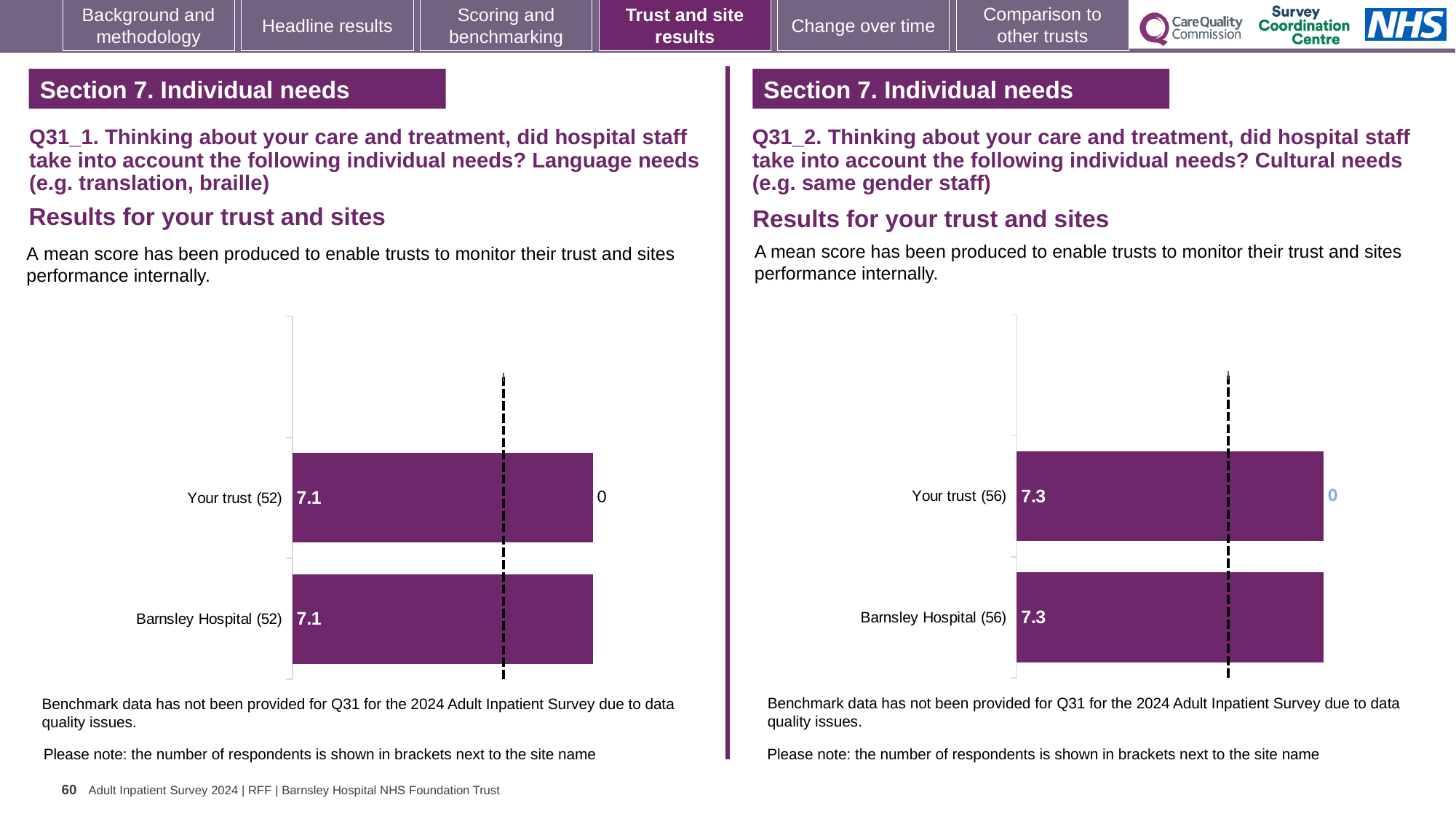
In the left chart (Q31_1, Language needs), what is the mean score for Your trust? 7.1 In the right chart (Q31_2, Cultural needs), what is the mean score for Your trust? 7.3 In the left chart (Q31_1, Language needs), how many respondents are shown in brackets next to Your trust? 52 In the right chart (Q31_2, Cultural needs), what is the mean score for Barnsley Hospital? 7.3 In the left chart (Q31_1, Language needs), what is the mean score for Barnsley Hospital? 7.1 In the left chart (Q31_1, Language needs), what is the difference between the scores for Your trust and Barnsley Hospital? 0.0 What type of chart is used in the left chart (Q31_1, Language needs)? Bar chart In the right chart (Q31_2, Cultural needs), how many respondents are shown in brackets next to Barnsley Hospital? 56 In the right chart (Q31_2, Cultural needs), what is the difference between the scores for Your trust and Barnsley Hospital? 0.0 How many bars are plotted in the left chart (Q31_1, Language needs)? 2 How many categories are shown in the right chart (Q31_2, Cultural needs)? 2 What type of chart is used in the right chart (Q31_2, Cultural needs)? Bar chart